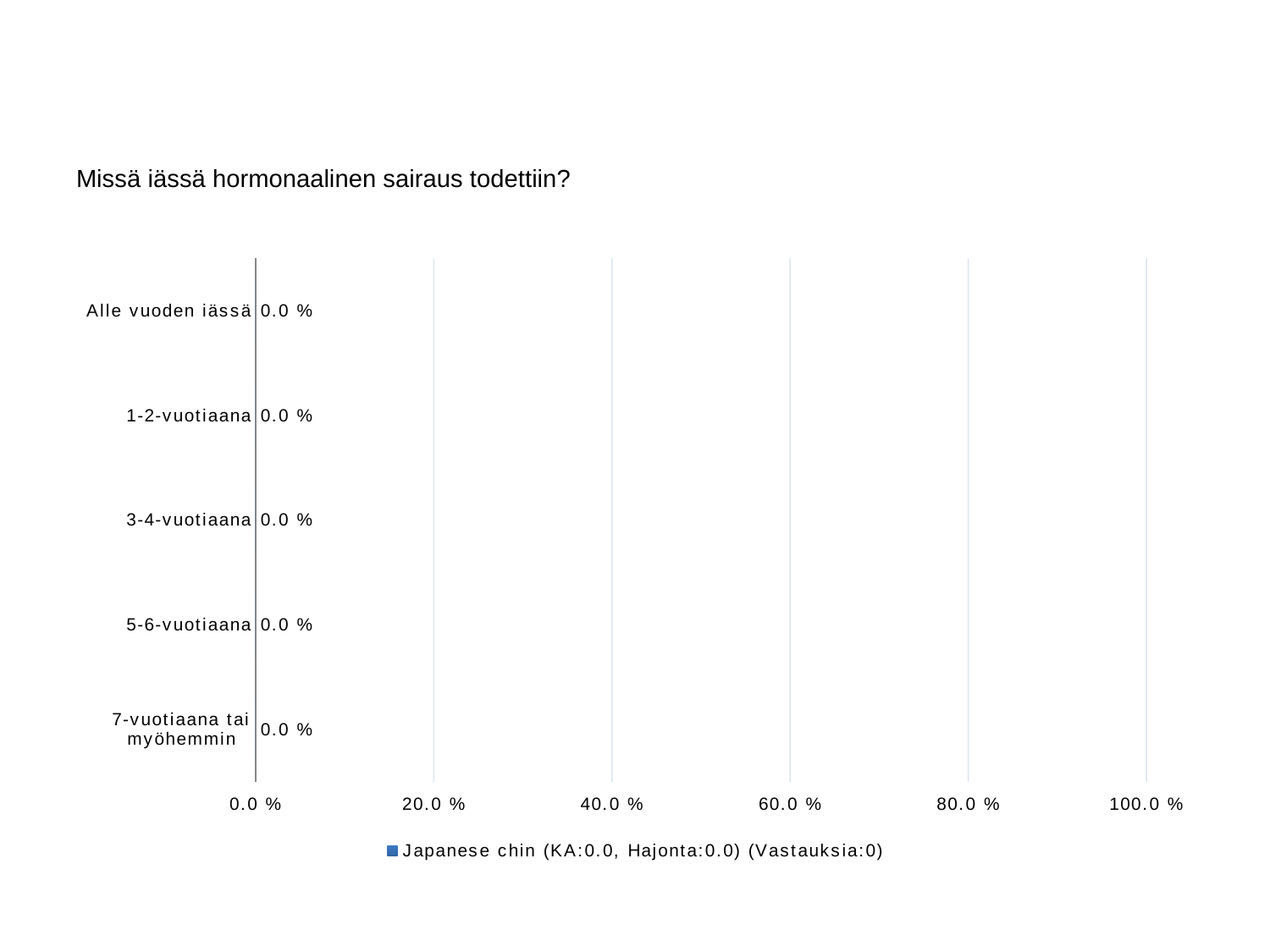
What is the difference between the values for "1-2-vuotiaana" and "5-6-vuotiaana"? 0.0 % What is the value for "3-4-vuotiaana"? 0.0 % What is the legend entry of the chart? Japanese chin (KA:0.0, Hajonta:0.0) (Vastauksia:0) Is the value for "3-4-vuotiaana" greater or less than 20.0 %? less What is the value for "5-6-vuotiaana"? 0.0 % How many series does the legend list? 1 What is the title of the chart? Missä iässä hormonaalinen sairaus todettiin? How many categories are shown on the chart? 5 What is the value for "1-2-vuotiaana"? 0.0 % What kind of chart is shown on the slide? bar chart What is the value for "7-vuotiaana tai myöhemmin"? 0.0 % What is the value for "Alle vuoden iässä"? 0.0 %